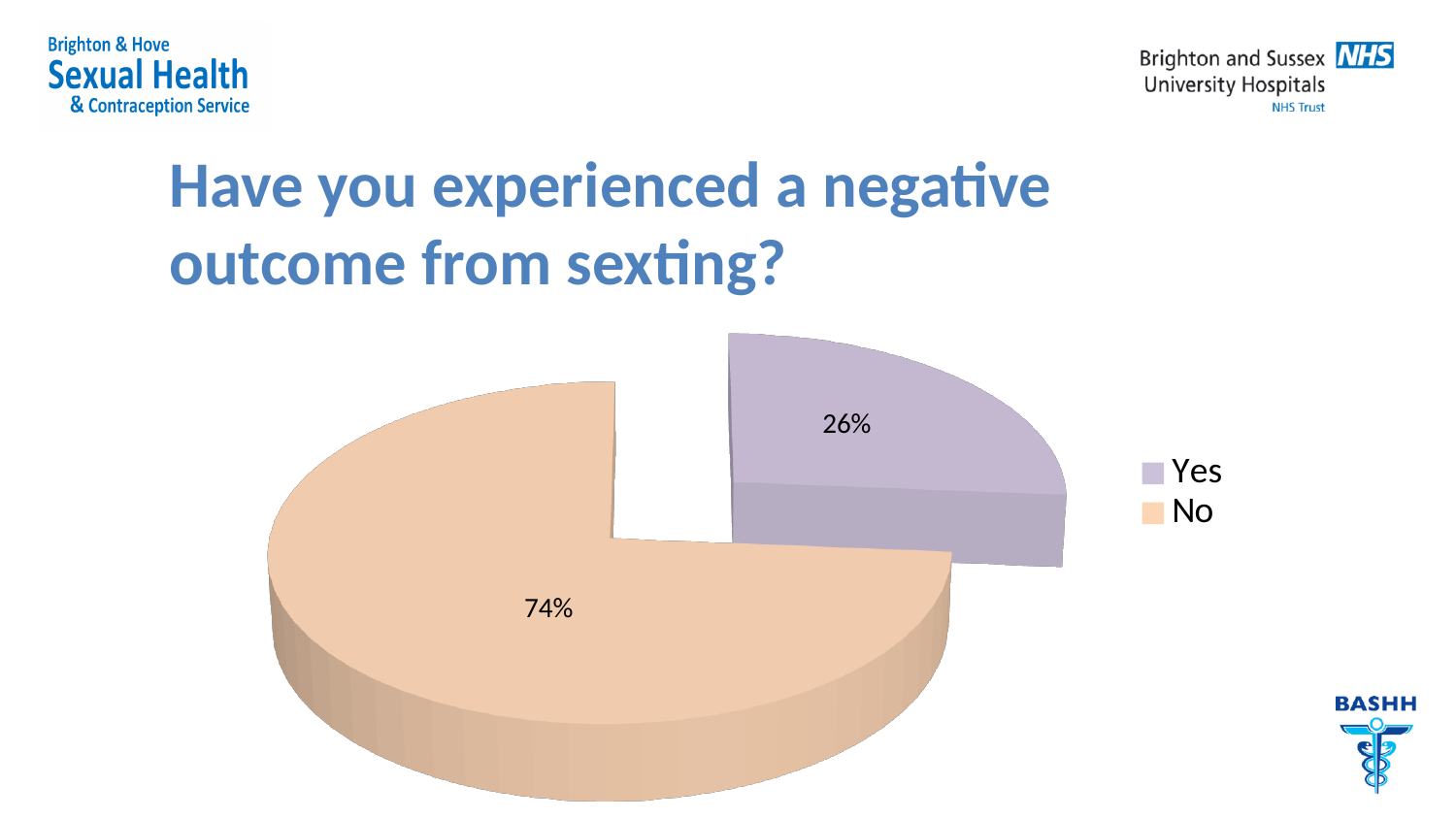
Which is larger, the "Yes" slice or the "No" slice? No What percentage of respondents answered "No"? 74% Which response has the smallest share of the pie? Yes Which response has the largest share of the pie? No What percentage of respondents answered "Yes" to having experienced a negative outcome from sexting? 26% How many entries does the legend list? 2 What question does the chart title ask? Have you experienced a negative outcome from sexting? How many slices does the pie chart have? 2 What kind of chart is shown on the slide? Pie chart Which colour represents the "Yes" response in the legend? Purple What is the difference in percentage points between the "No" and "Yes" slices? 48 What share of the pie does the "Yes" slice represent? 26%